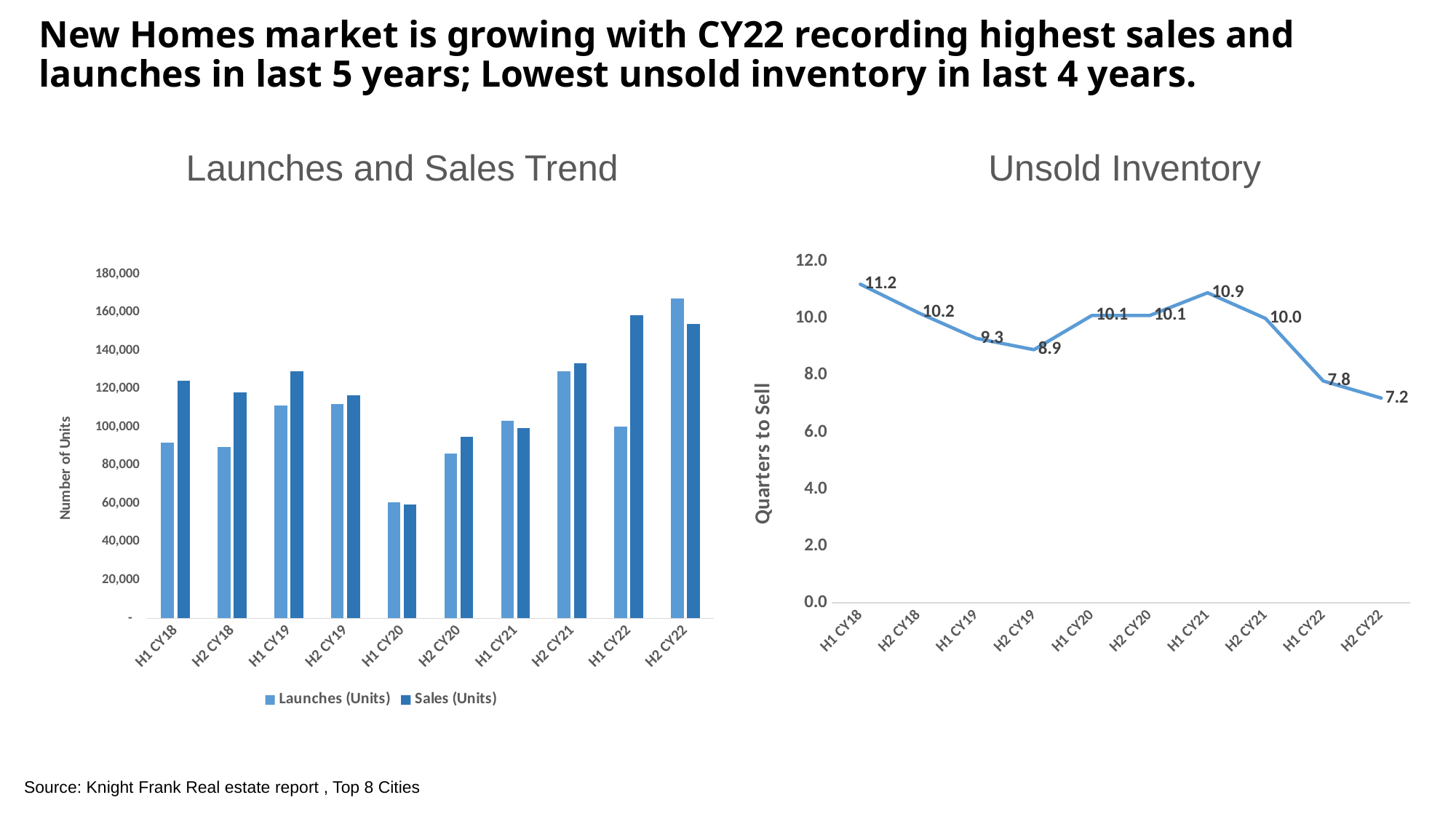
How many series does the legend of the Launches and Sales Trend chart list? 2 In the Launches and Sales Trend chart, is the value for Launches (Units) in H2 CY22 greater or less than 160,000? greater In the Unsold Inventory chart, how many data points are plotted? 10 In the Launches and Sales Trend chart, is the value for Launches (Units) in H1 CY18 greater or less than 100,000? less In the Unsold Inventory chart, what is the value for H1 CY18? 11.2 In the Unsold Inventory chart, what is the difference between the values for H1 CY18 and H2 CY22? 4.0 In the Unsold Inventory chart, which period has the lowest quarters to sell? H2 CY22 In the Unsold Inventory chart, what is the y-axis label? Quarters to Sell What kind of chart is the Launches and Sales Trend chart? Bar chart In the Unsold Inventory chart, what is the value for H2 CY22? 7.2 In the Unsold Inventory chart, which period has the highest quarters to sell? H1 CY18 In the Launches and Sales Trend chart, which is larger for H1 CY22: Launches (Units) or Sales (Units)? Sales (Units)